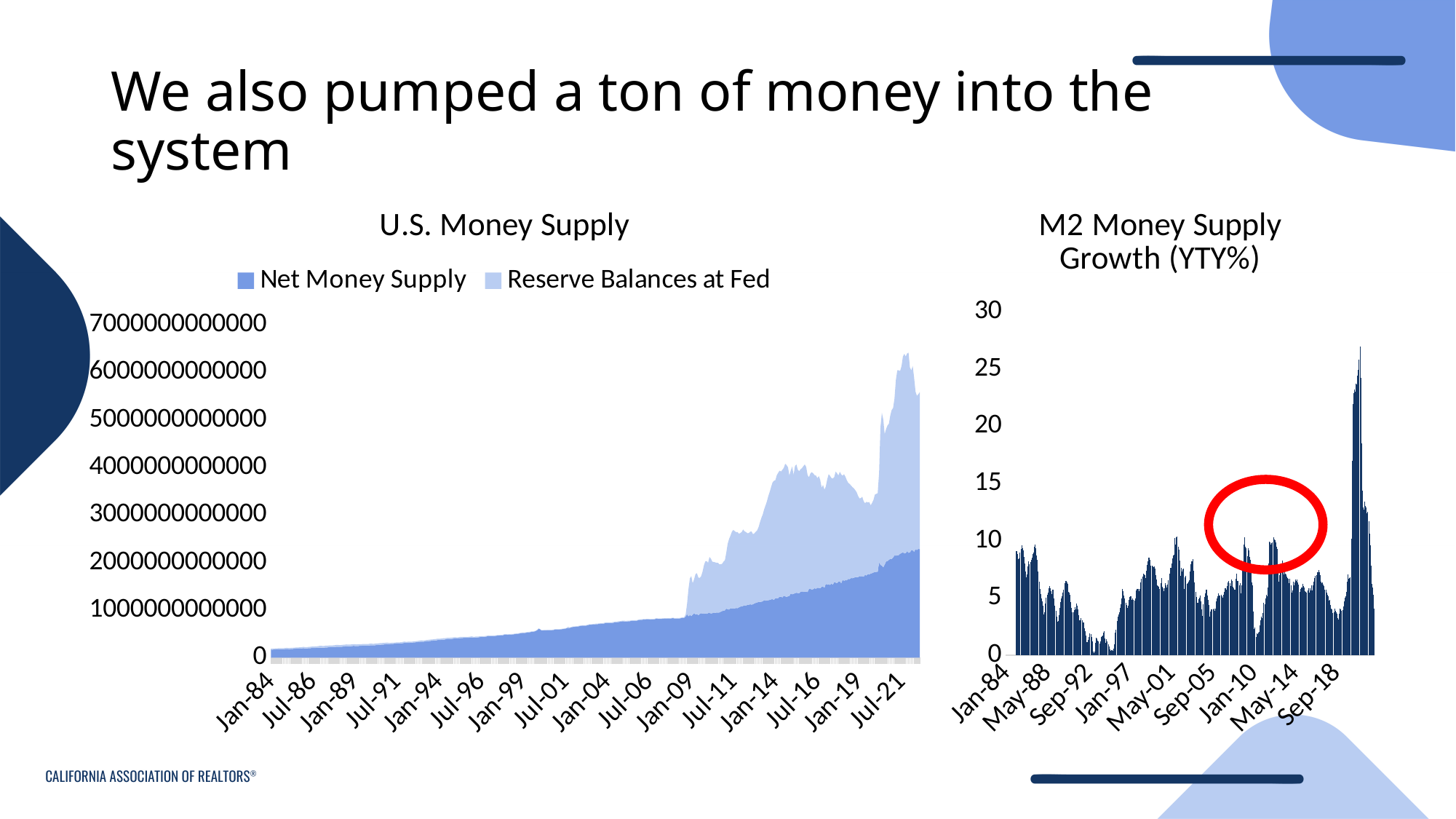
In the "U.S. Money Supply" chart, around Jan-14, which series is larger: Net Money Supply or Reserve Balances at Fed? Reserve Balances at Fed In the "M2 Money Supply Growth (YTY%)" chart, what is the highest value shown on the y axis? 30 How many date labels are shown on the x axis of the "M2 Money Supply Growth (YTY%)" chart? 9 In the "M2 Money Supply Growth (YTY%)" chart, is the highest bar greater or less than 20? greater In the "U.S. Money Supply" chart, does the total money supply generally rise or fall from Jan-84 to Jul-21? rise What kind of chart is the "M2 Money Supply Growth (YTY%)" chart on the right? bar chart What kind of chart is the "U.S. Money Supply" chart on the left? area chart In the "U.S. Money Supply" chart, what are the two series named in the legend? Net Money Supply and Reserve Balances at Fed In the "U.S. Money Supply" chart, is the total value at Jan-84 greater or less than 1000000000000? less In the "M2 Money Supply Growth (YTY%)" chart, in which period does the highest growth occur: around Jan-84 or after Sep-18? after Sep-18 How many series does the legend of the "U.S. Money Supply" chart list? 2 In the "U.S. Money Supply" chart, is the peak total value reached around 2021 greater or less than 6000000000000? greater